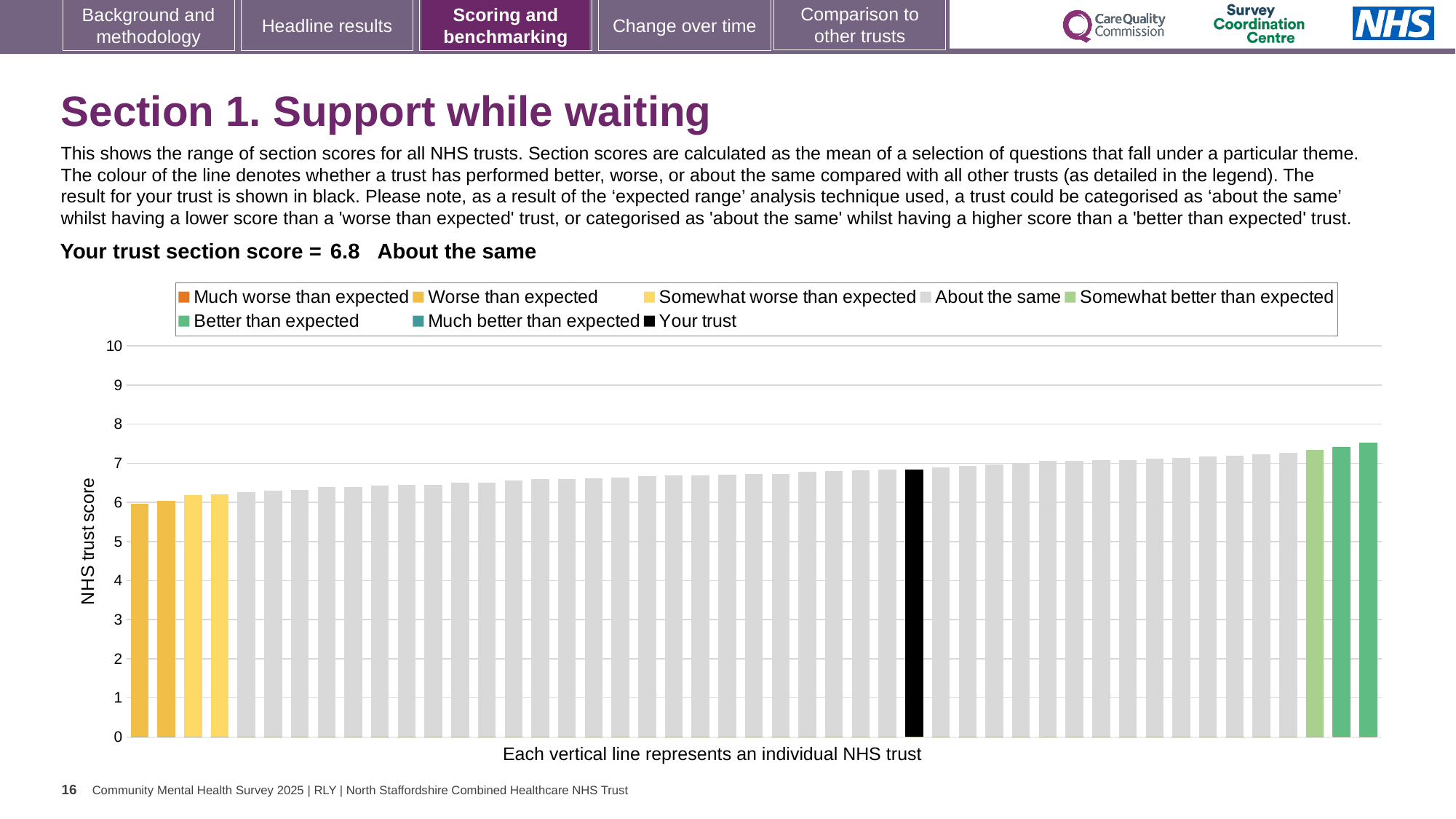
What is the label on the y axis of the chart? NHS trust score How many entries does the chart legend list? 8 What kind of chart is shown on the slide? bar chart Is the value for your trust (the black bar) greater or less than 5? greater Is the value of the highest bar greater or less than 8? less What is the section score for your trust shown on the slide? 6.8 Do the bar values rise or fall from left to right along the x axis? rise How many bars are coloured as 'Worse than expected'? 2 Is the value of the lowest bar greater or less than 7? less How many bars are coloured as 'Better than expected'? 2 Which category is your trust placed in for this section? About the same What colour is used for the bar representing your trust? black